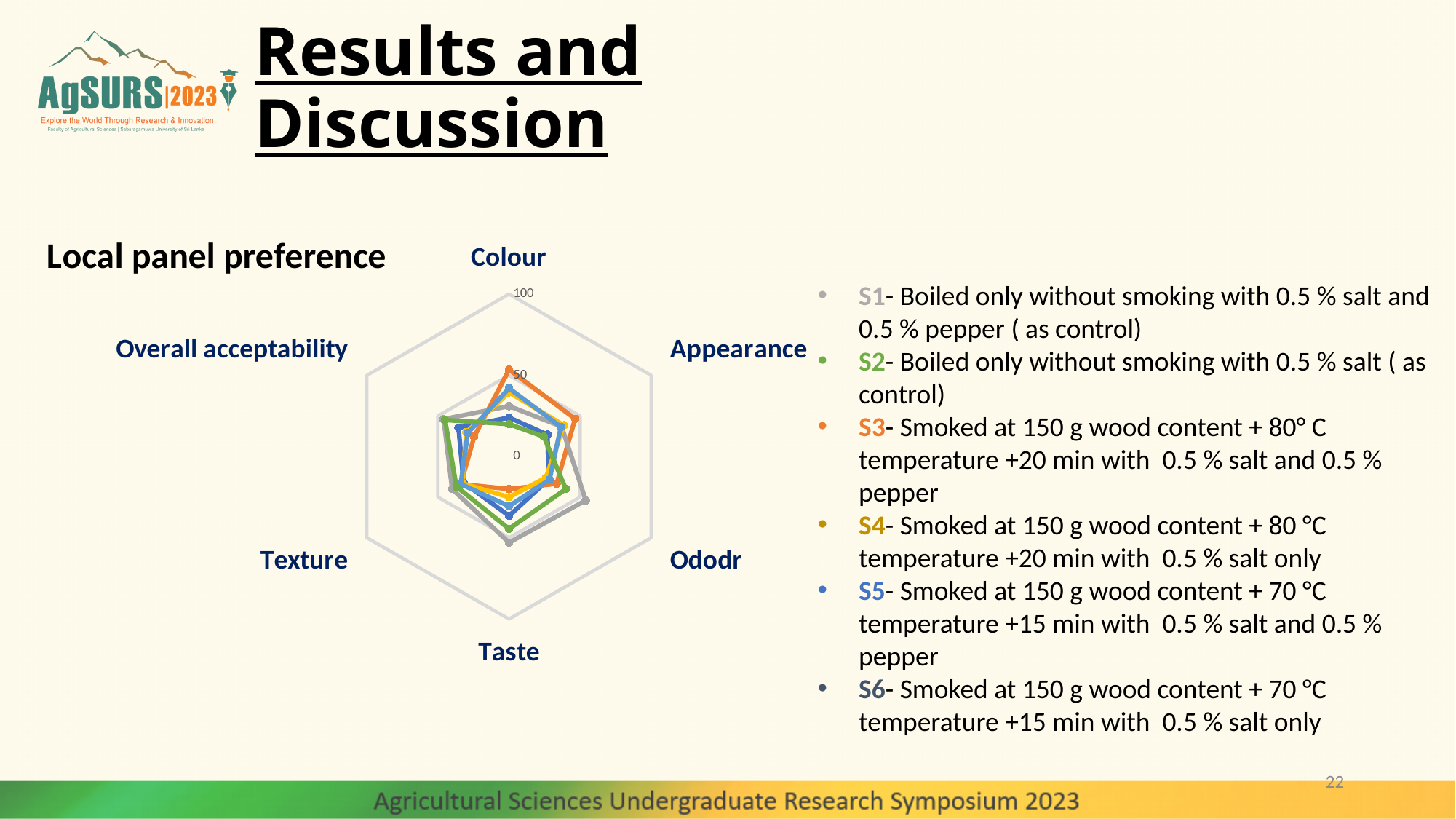
Which series has a higher Colour value, S3 (orange) or S1 (grey)? S3 Is the Appearance value for S6 (dark blue) greater or less than 50? less Is the Taste value for S3 (orange) greater or less than 50? less Is the Colour value for S6 (dark blue) greater or less than 50? less What is the title given to the radar chart on the slide? Local panel preference How many attribute axes does the radar chart have? 6 What is the maximum value shown on the radar chart's axis scale? 100 How many series (S1 to S6) are plotted on the radar chart? 6 What kind of chart is shown on the slide? Radar chart